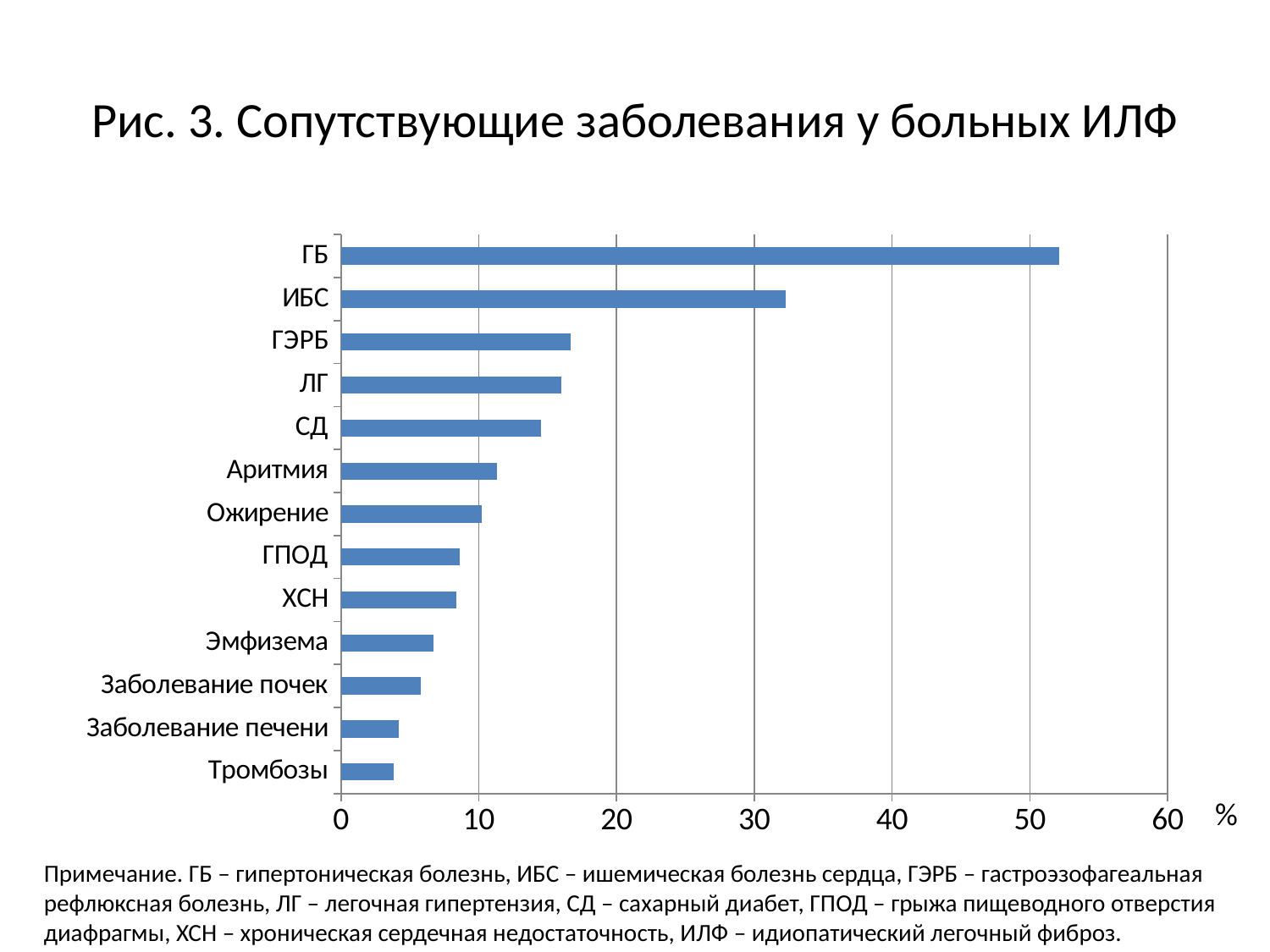
Which is larger, the value for ИБС or the value for ГЭРБ? ИБС What is the title of the chart on the slide? Рис. 3. Сопутствующие заболевания у больных ИЛФ What unit is shown at the end of the horizontal axis? % Is the value for Эмфизема greater or less than 10? less Is the value for ГБ greater or less than 50? greater How many categories are plotted in the chart? 13 Which is larger, the value for СД or the value for Ожирение? СД Which category has the highest value? ГБ Is the value for Аритмия greater or less than 10? greater What kind of chart is shown on the slide? bar chart